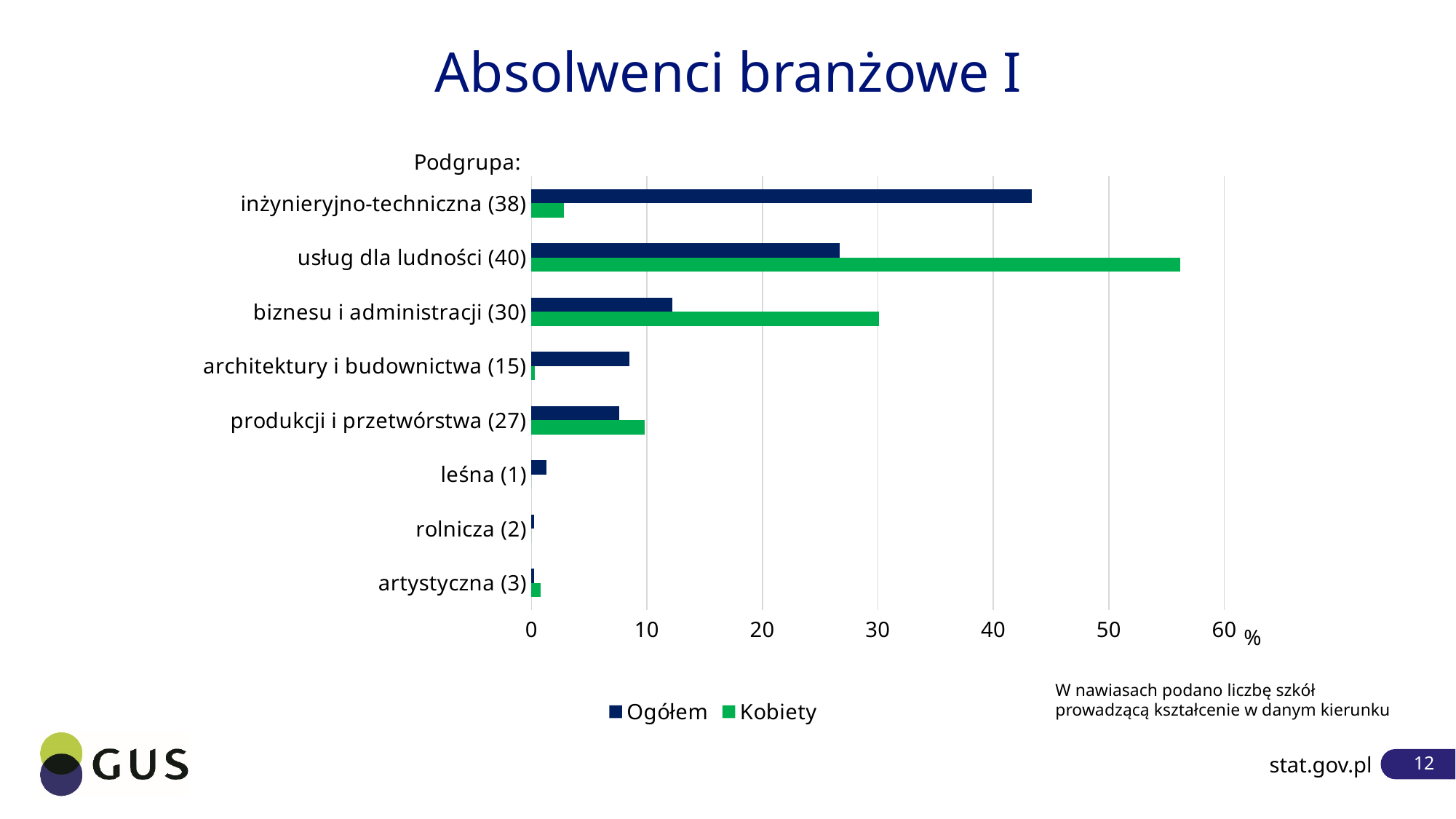
Is the Kobiety value for usług dla ludności (40) greater or less than 50? greater For usług dla ludności (40), which series has the larger value, Ogółem or Kobiety? Kobiety Is the Ogółem value for architektury i budownictwa (15) greater or less than 10? less How many series does the legend list? 2 Which subgroup has the highest value for Ogółem? inżynieryjno-techniczna (38) How many subgroup categories are plotted on the chart? 8 Which subgroup has the highest value for Kobiety? usług dla ludności (40) For inżynieryjno-techniczna (38), which series has the larger value, Ogółem or Kobiety? Ogółem Is the Ogółem value for inżynieryjno-techniczna (38) greater or less than 40? greater What are the two legend entries of the chart? Ogółem and Kobiety What kind of chart is shown on the slide? bar chart